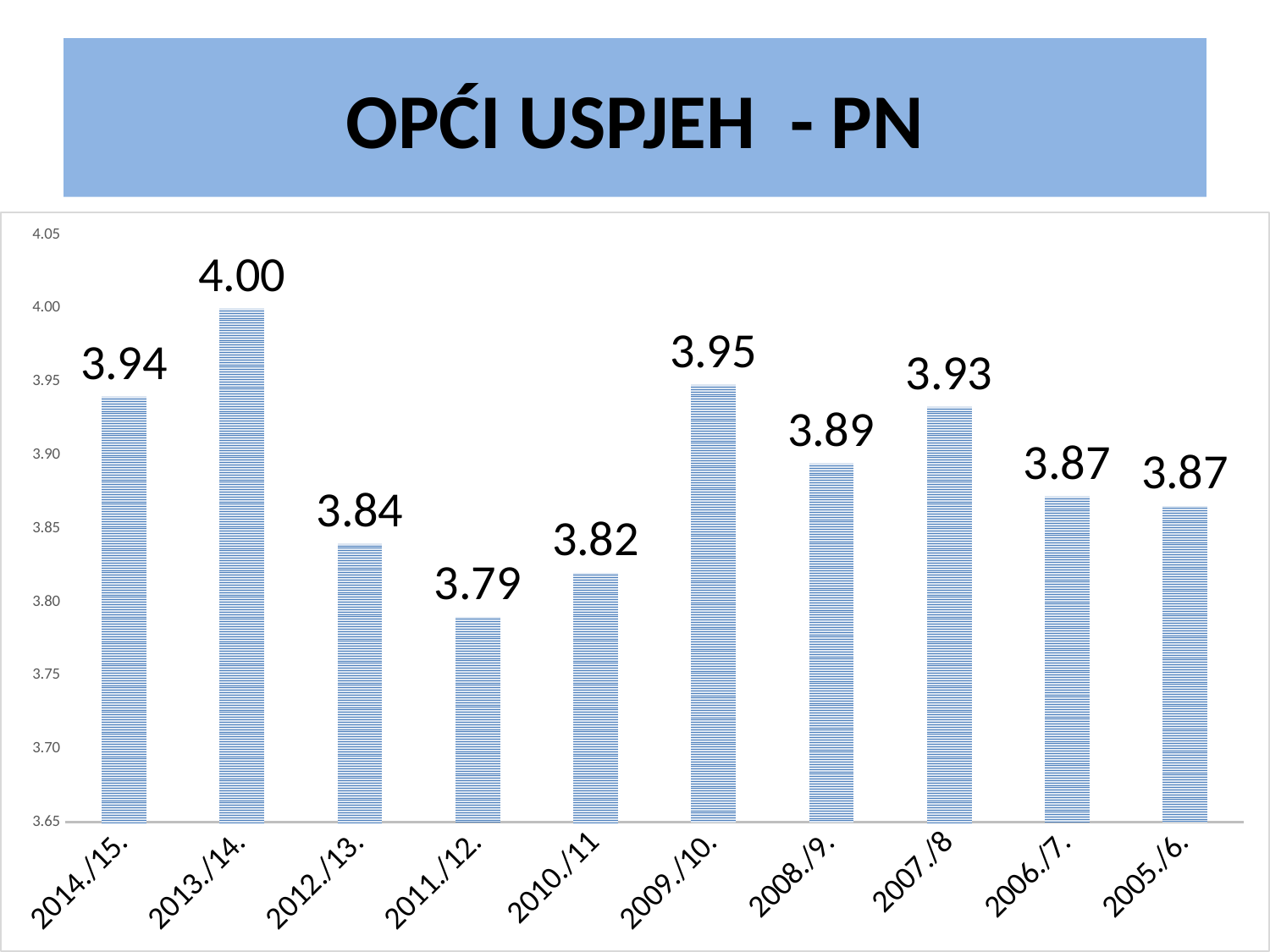
What is the value for 2013./14.? 4.00 Which school year has the highest value? 2013./14. What is the difference between the values for 2013./14. and 2011./12.? 0.21 What is the difference between the values for 2008./9. and 2007./8? 0.04 What is the value for 2009./10.? 3.95 Is the value for 2012./13. greater or less than 3.85? less What is the title of the slide? OPĆI USPJEH - PN How many school years are shown on the x axis? 10 Which school year has the lowest value? 2011./12. Which is larger, the value for 2014./15. or the value for 2009./10.? 2009./10. What is the value for 2011./12.? 3.79 What kind of chart is shown on the slide? bar chart